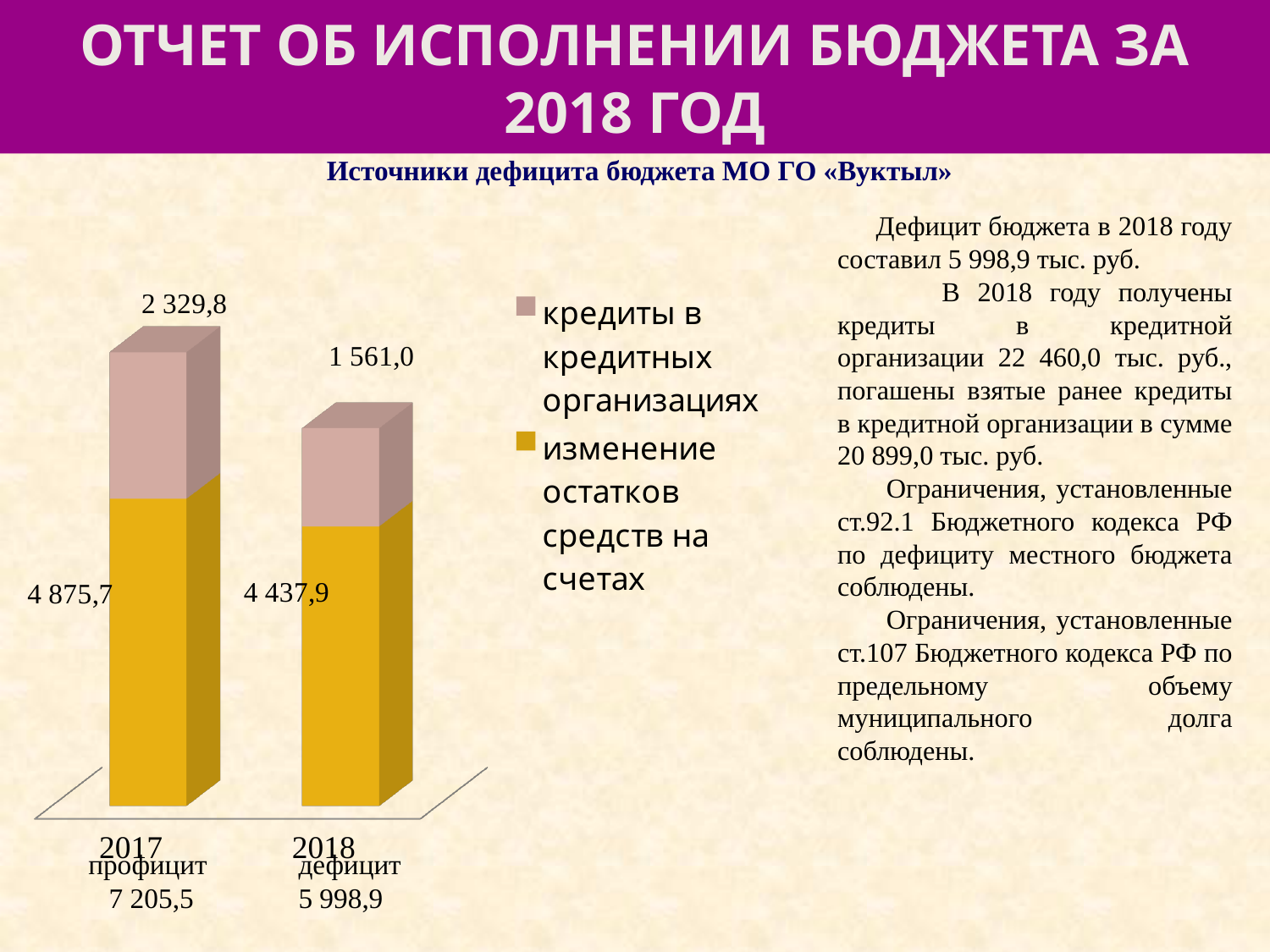
How many categories (years) are shown on the x axis of the chart? 2 What is the value of "кредиты в кредитных организациях" for 2017? 2 329,8 What kind of chart is shown on the slide? stacked bar chart What is the total of the stacked bar for 2018? 5 998,9 What is the title of the chart? Источники дефицита бюджета МО ГО «Вуктыл» What is the value of "изменение остатков средств на счетах" for 2018? 4 437,9 Which year has the higher value for "кредиты в кредитных организациях"? 2017 How many series does the chart legend list? 2 What is the value of "кредиты в кредитных организациях" for 2018? 1 561,0 What is the value of "изменение остатков средств на счетах" for 2017? 4 875,7 What is the difference between the 2017 and 2018 values of "изменение остатков средств на счетах"? 437,8 Does the stacked total rise or fall from 2017 to 2018? fall